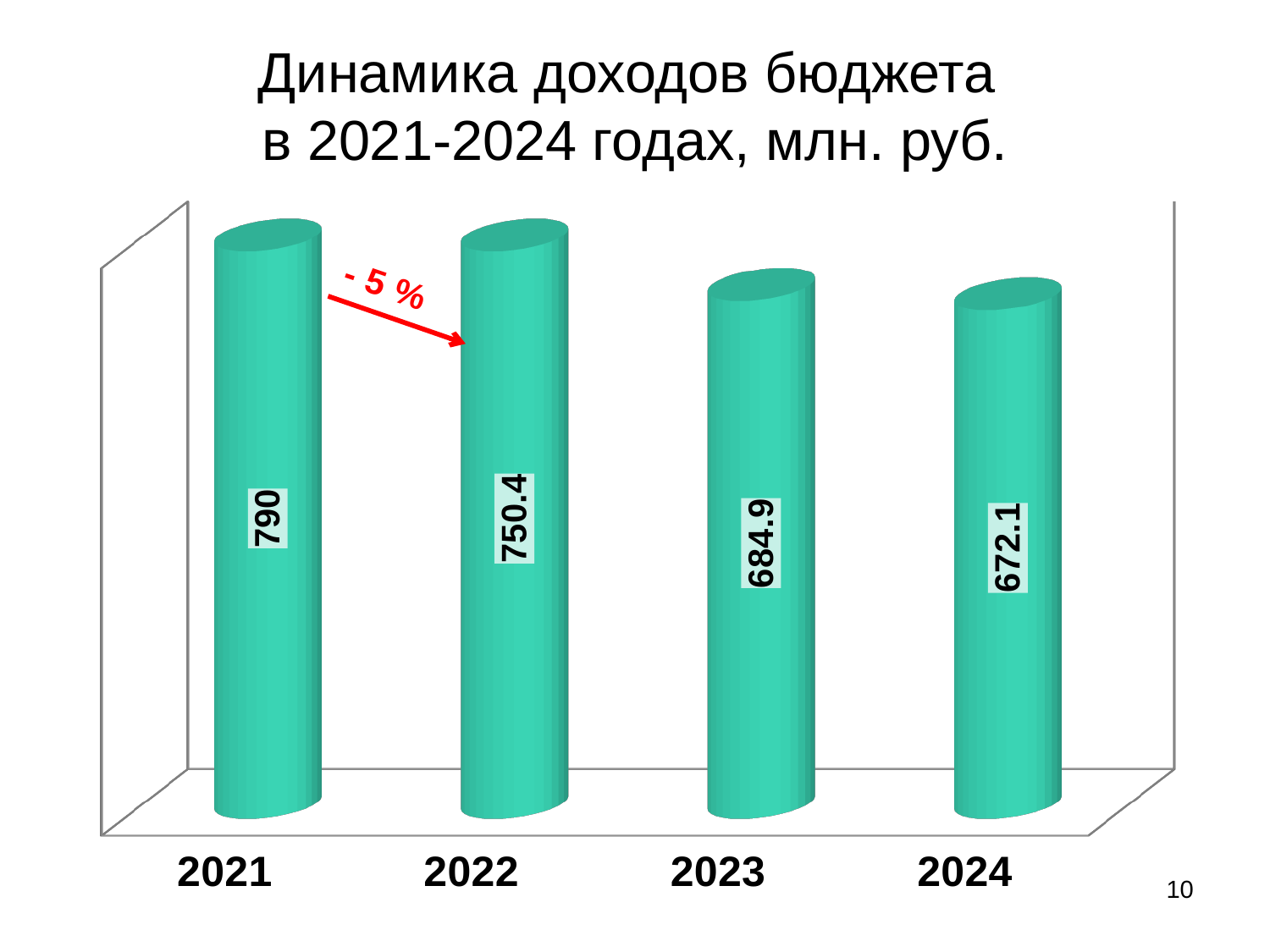
Which year has the highest budget revenue? 2021 Which year has the lowest budget revenue? 2024 What is the difference between the 2023 and 2024 values? 12.8 Do the values rise or fall from 2021 to 2024? Fall What kind of chart is shown on the slide? Bar chart How many years are shown on the chart? 4 What is the budget revenue value for 2022? 750.4 Which is larger, the value for 2022 or the value for 2023? 2022 What is the budget revenue value for 2021? 790 What is the difference between the 2021 and 2022 values? 39.6 What is the budget revenue value for 2023? 684.9 What is the budget revenue value for 2024? 672.1